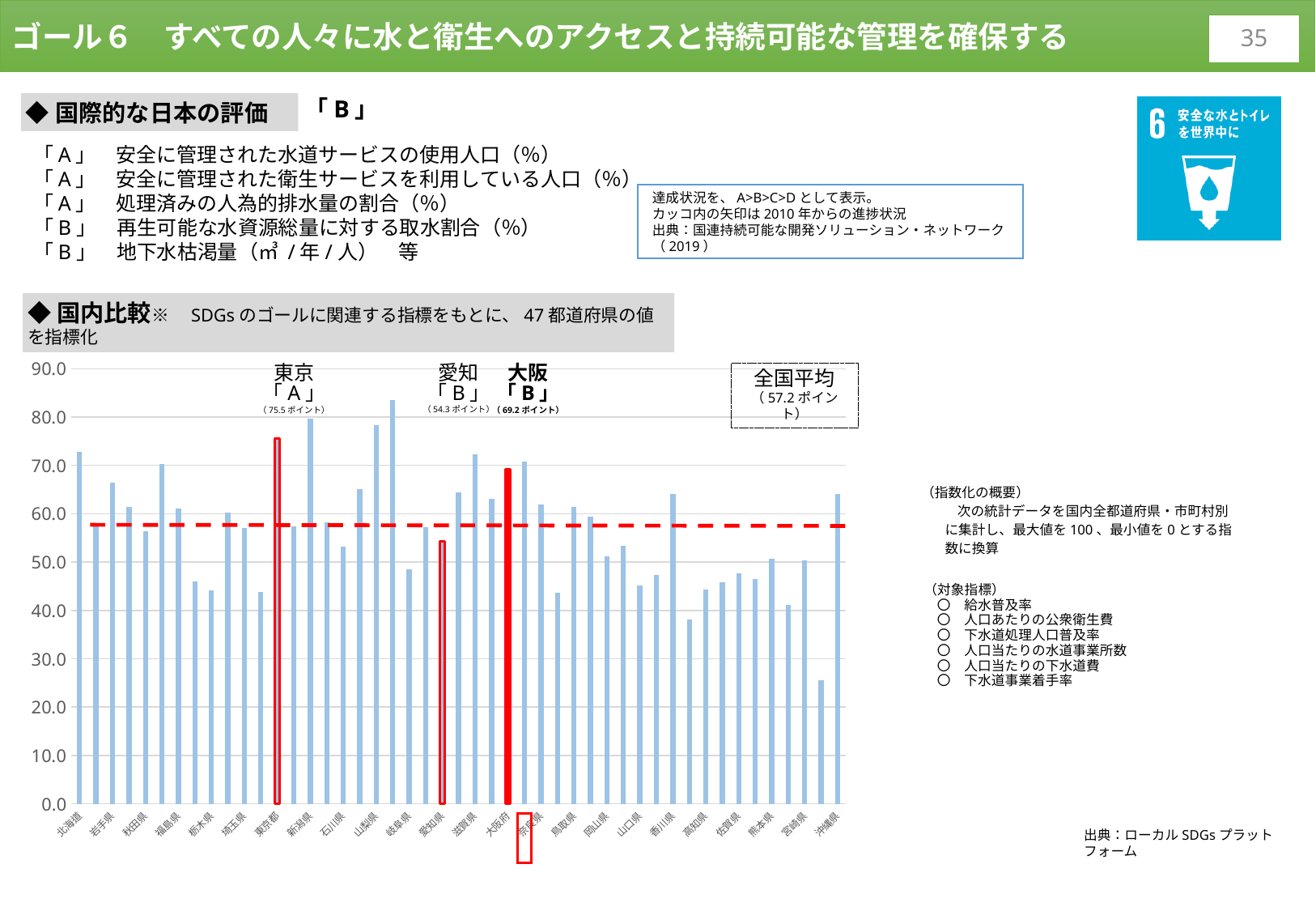
What is the value for 東京 in the 国内比較 bar chart? 75.5 ポイント What is the difference between the values for 大阪 and 愛知? 14.9 ポイント What is the value for 大阪 in the 国内比較 bar chart? 69.2 ポイント Is the value for 北海道 greater or less than 70? greater What is the 全国平均 value shown on the chart? 57.2 ポイント Which has the larger value, 東京 or 大阪? 東京 Is the value for 沖縄県 greater or less than 60? greater What is the difference between the values for 東京 and 大阪? 6.3 ポイント What is the value for 愛知 in the 国内比較 bar chart? 54.3 ポイント What does the red dashed horizontal line on the chart represent? 全国平均 What kind of chart is used for the 国内比較? bar chart Which is larger, the value for 愛知 or the 全国平均? 全国平均